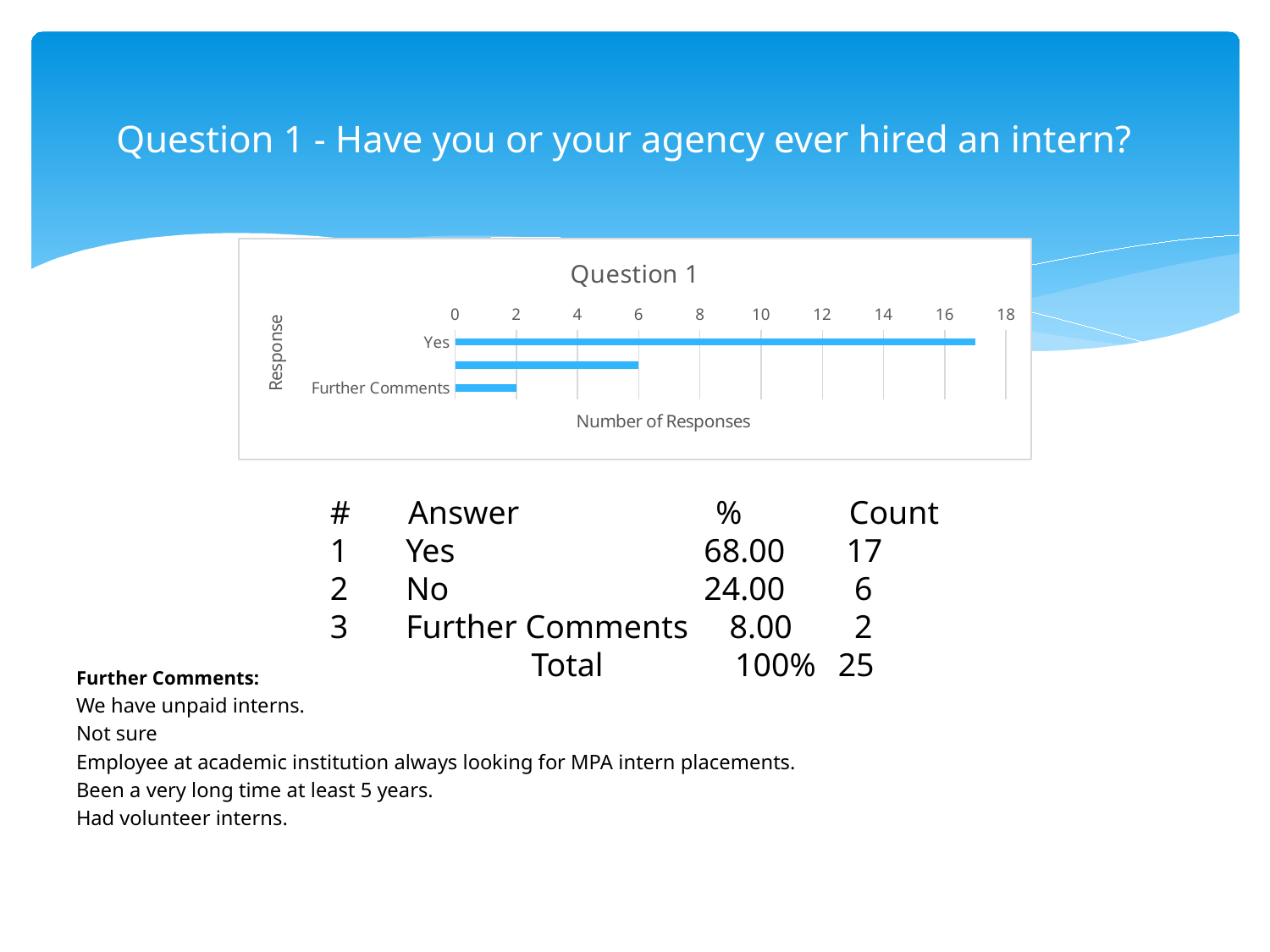
What is the title of the horizontal axis of the chart? Number of Responses What is the number of responses for Yes? 17 Is the value for Further Comments greater or less than 4? less What kind of chart is shown on the slide? bar chart What is the difference between the number of responses for Yes and for Further Comments? 15 How many bars are plotted in the Question 1 chart? 3 Which response has the lowest number of responses in the chart? Further Comments Is the value for Yes greater or less than 16? greater What is the number of responses for Further Comments? 2 Which has more responses, Yes or Further Comments? Yes What is the title of the chart? Question 1 Which response has the highest number of responses in the chart? Yes